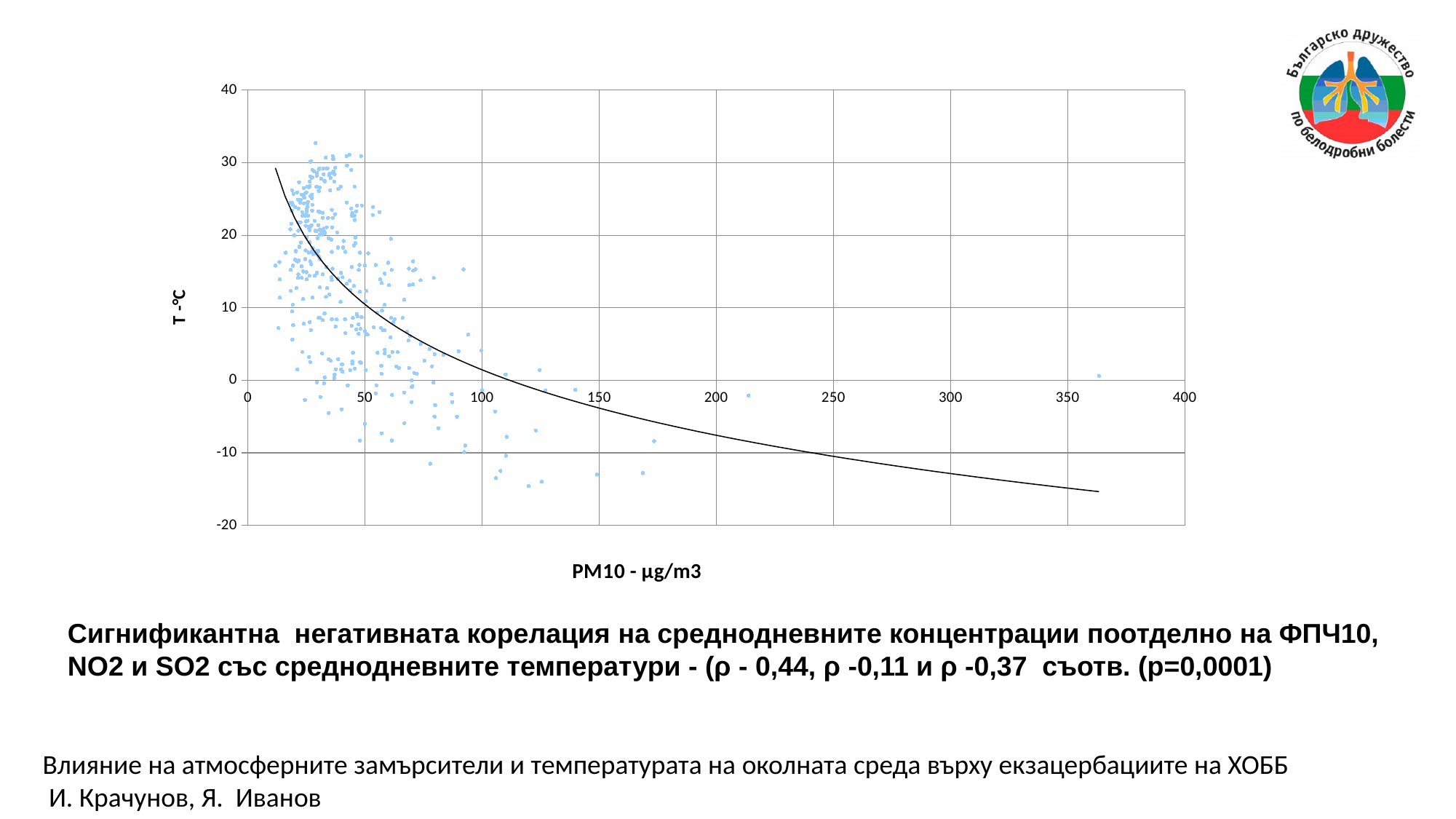
What is the label of the x axis of the chart? PM10 - µg/m3 Is the temperature at the left end of the fitted curve (near PM10 = 0) greater or less than 20? greater Is the temperature at the right end of the fitted curve (near PM10 = 350) greater or less than -10? less What kind of chart is shown on the slide? scatter plot As PM10 increases along the x axis, does the fitted curve rise or fall? fall What is the label of the y axis of the chart? T -°C